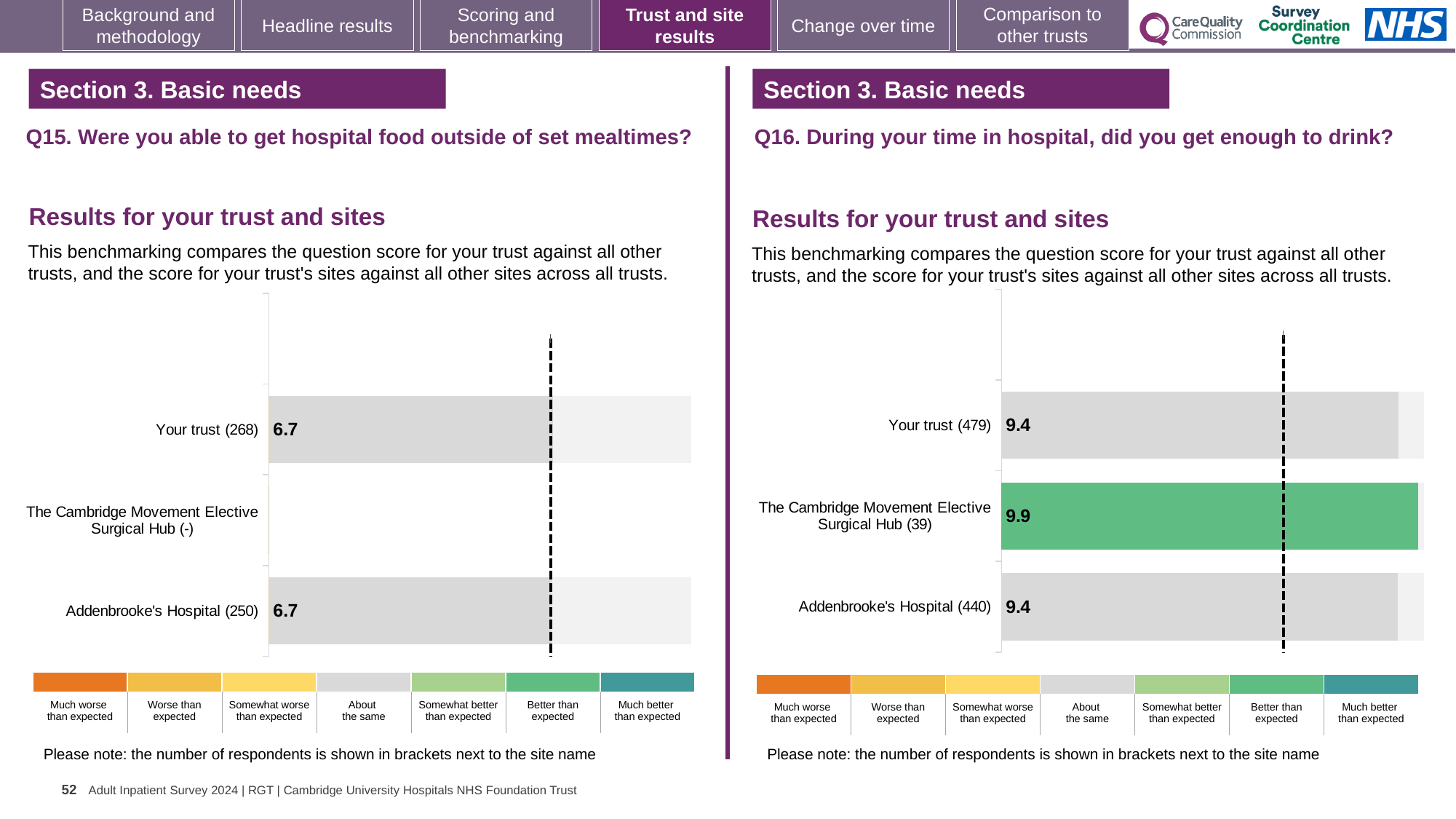
In the Q16 chart, which site or trust has the highest score? The Cambridge Movement Elective Surgical Hub What kind of chart is used for the Q16 results? Bar chart In the Q16 chart, how many respondents are shown in brackets for Addenbrooke's Hospital? 440 In the Q16 chart, what is the score for Addenbrooke's Hospital? 9.4 In the Q15 chart, what is the score for Addenbrooke's Hospital? 6.7 In the Q16 chart, which benchmark category does the colour of The Cambridge Movement Elective Surgical Hub bar correspond to? Better than expected In the Q16 chart, what is the score for Your trust? 9.4 How many categories are listed on the y axis of the Q15 chart? 3 In the Q16 chart, what is the difference between the score for The Cambridge Movement Elective Surgical Hub and the score for Your trust? 0.5 In the Q15 chart, what is the score for Your trust? 6.7 In the Q16 chart, what is the score for The Cambridge Movement Elective Surgical Hub? 9.9 In the Q16 chart, which has the larger score: The Cambridge Movement Elective Surgical Hub or Addenbrooke's Hospital? The Cambridge Movement Elective Surgical Hub